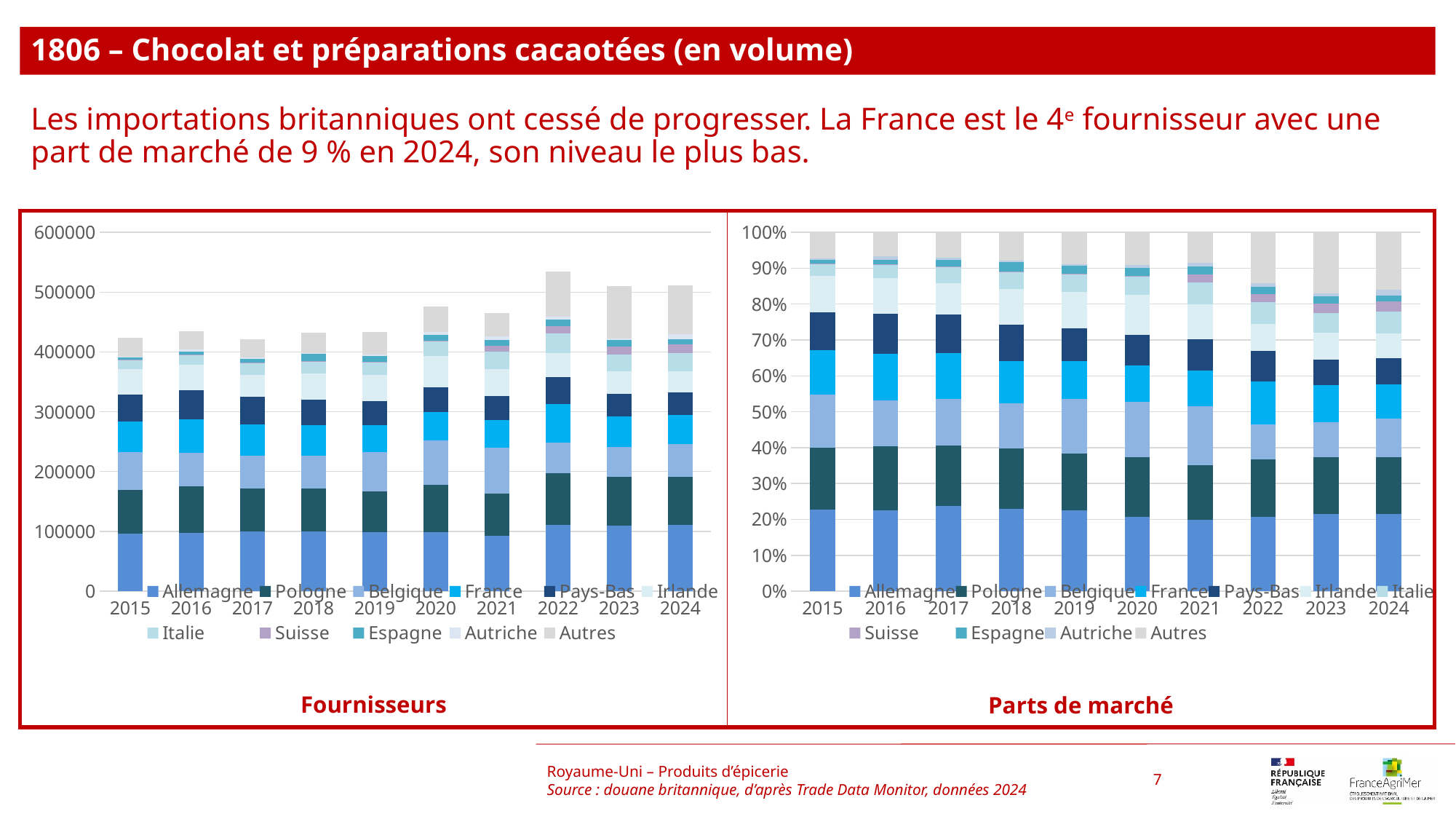
In the 'Fournisseurs' chart, is the value for Allemagne in 2022 greater or less than 100000? greater In the 'Fournisseurs' chart, is the total for 2015 greater or less than 450000? less In the 'Parts de marché' chart, is the share of Autres in 2024 greater or less than 10%? greater In the 'Fournisseurs' chart, is the total bar for 2022 larger or smaller than the total bar for 2015? larger In the 'Fournisseurs' chart, which year has the highest total bar? 2022 How many years are shown on the x axis of the 'Parts de marché' chart? 10 What kind of chart is the 'Fournisseurs' chart on the left? stacked bar chart What is the title of the chart on the right of the slide? Parts de marché How many series does the legend of the 'Fournisseurs' chart list? 11 Which series is plotted at the bottom of each stacked bar in the 'Parts de marché' chart? Allemagne